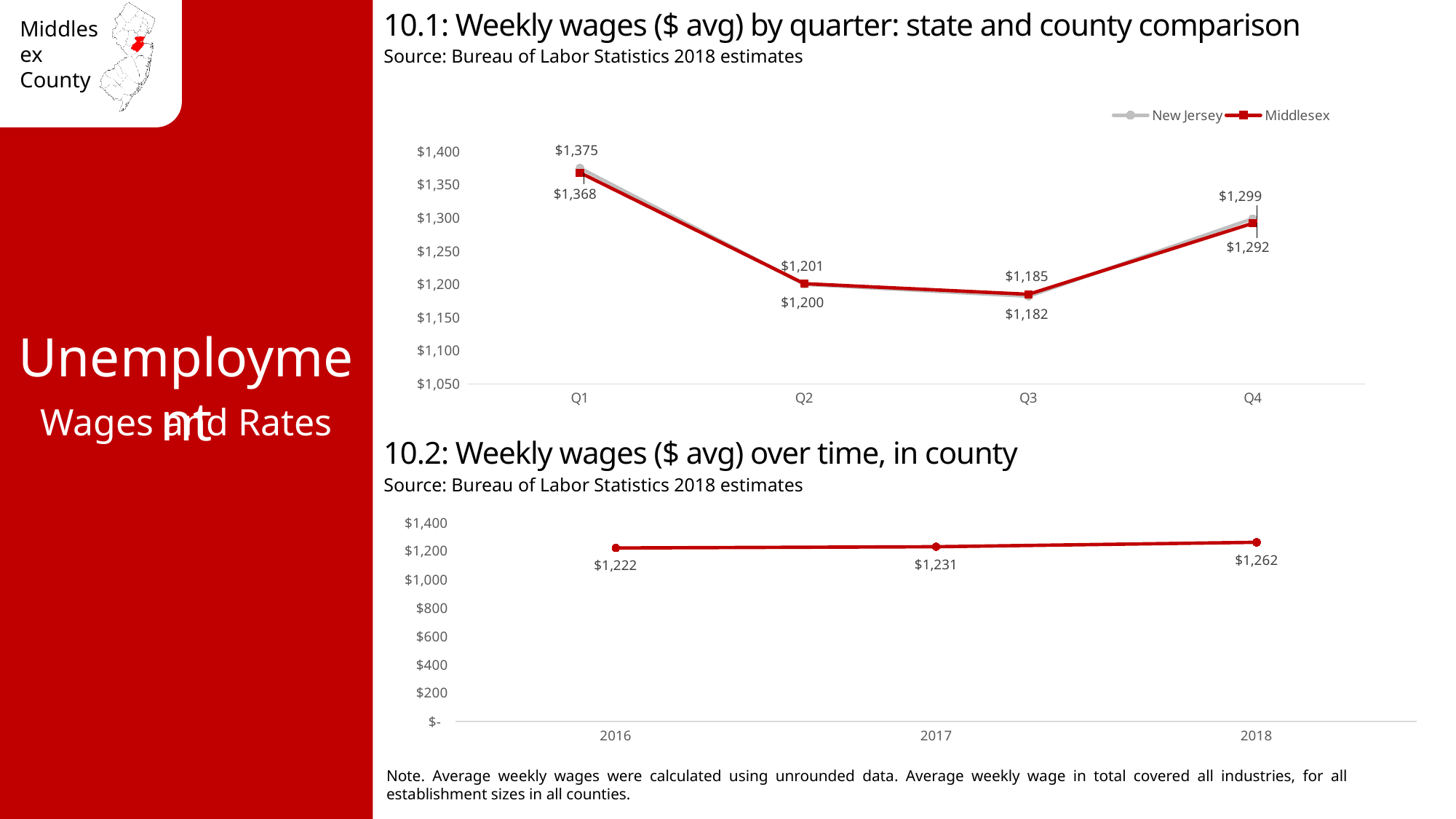
In chart 10.1 (Weekly wages by quarter: state and county comparison), what kind of chart is shown? line chart In chart 10.1 (Weekly wages by quarter: state and county comparison), what is the New Jersey value for Q4? $1,299 In chart 10.2 (Weekly wages over time, in county), how many years are plotted? 3 In chart 10.2 (Weekly wages over time, in county), what is the average weekly wage for 2018? $1,262 In chart 10.2 (Weekly wages over time, in county), which year has the highest average weekly wage? 2018 In chart 10.2 (Weekly wages over time, in county), what is the average weekly wage for 2016? $1,222 In chart 10.2 (Weekly wages over time, in county), how much higher is the 2018 value than the 2016 value? $40 In chart 10.1 (Weekly wages by quarter: state and county comparison), how many series does the legend list? 2 In chart 10.1 (Weekly wages by quarter: state and county comparison), which quarter has the lowest weekly wages for both series? Q3 In chart 10.1 (Weekly wages by quarter: state and county comparison), what is the Middlesex value for Q1? $1,368 In chart 10.2 (Weekly wages over time, in county), do the values rise or fall from 2016 to 2018? rise In chart 10.1 (Weekly wages by quarter: state and county comparison), which series is drawn in red? Middlesex